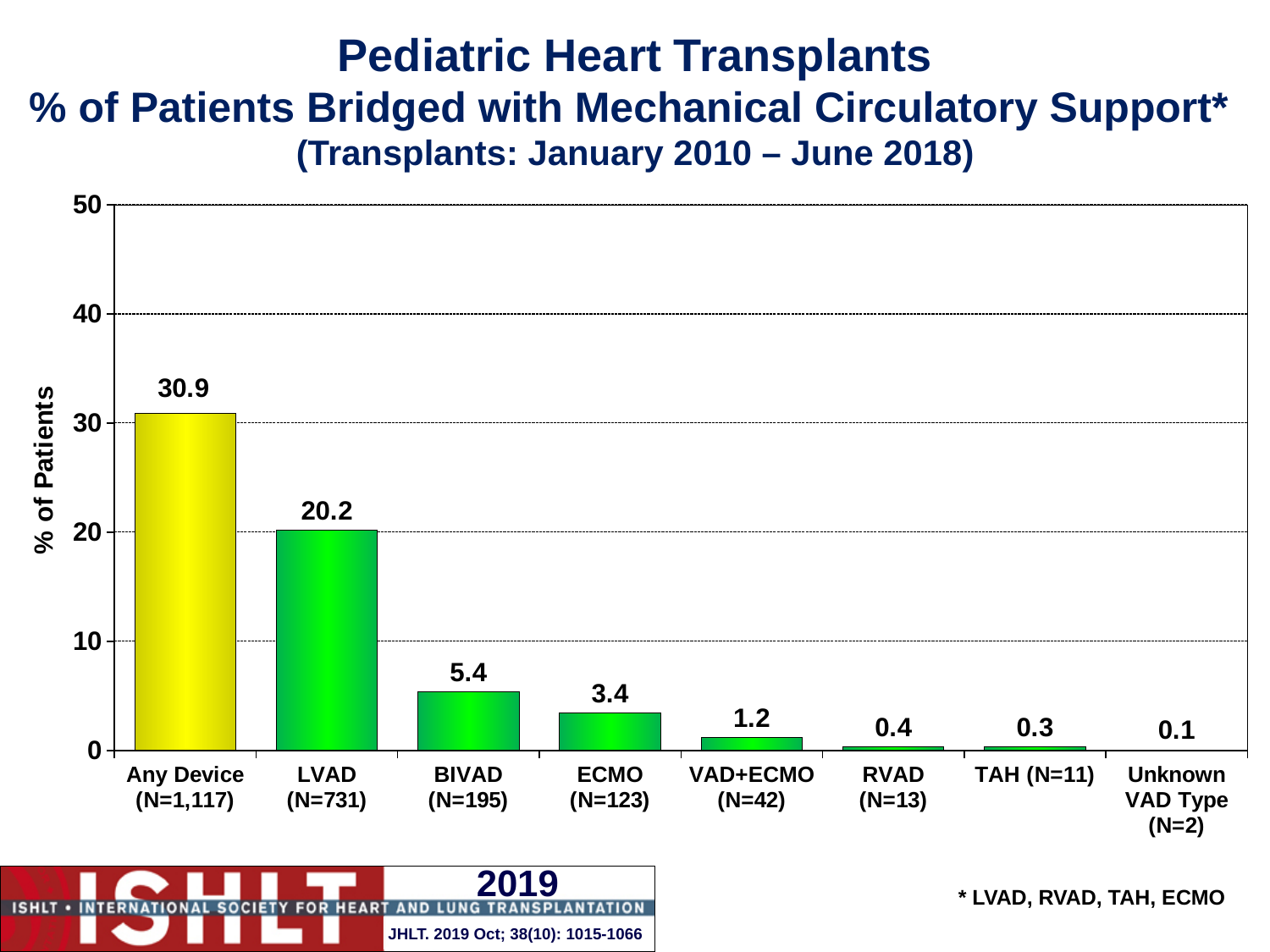
What is the label of the y axis? % of Patients Which category has the highest value? Any Device What is the value for VAD+ECMO? 1.2 What is the difference between the values for LVAD and BIVAD? 14.8 Which category has the lowest value? Unknown VAD Type What percentage of patients were bridged with any device? 30.9 How many categories are shown on the x axis? 8 What is the value for LVAD? 20.2 What kind of chart is this? bar chart Is the value for Any Device greater or less than 30? greater What is the value for ECMO? 3.4 Which is larger, the value for BIVAD or the value for ECMO? BIVAD